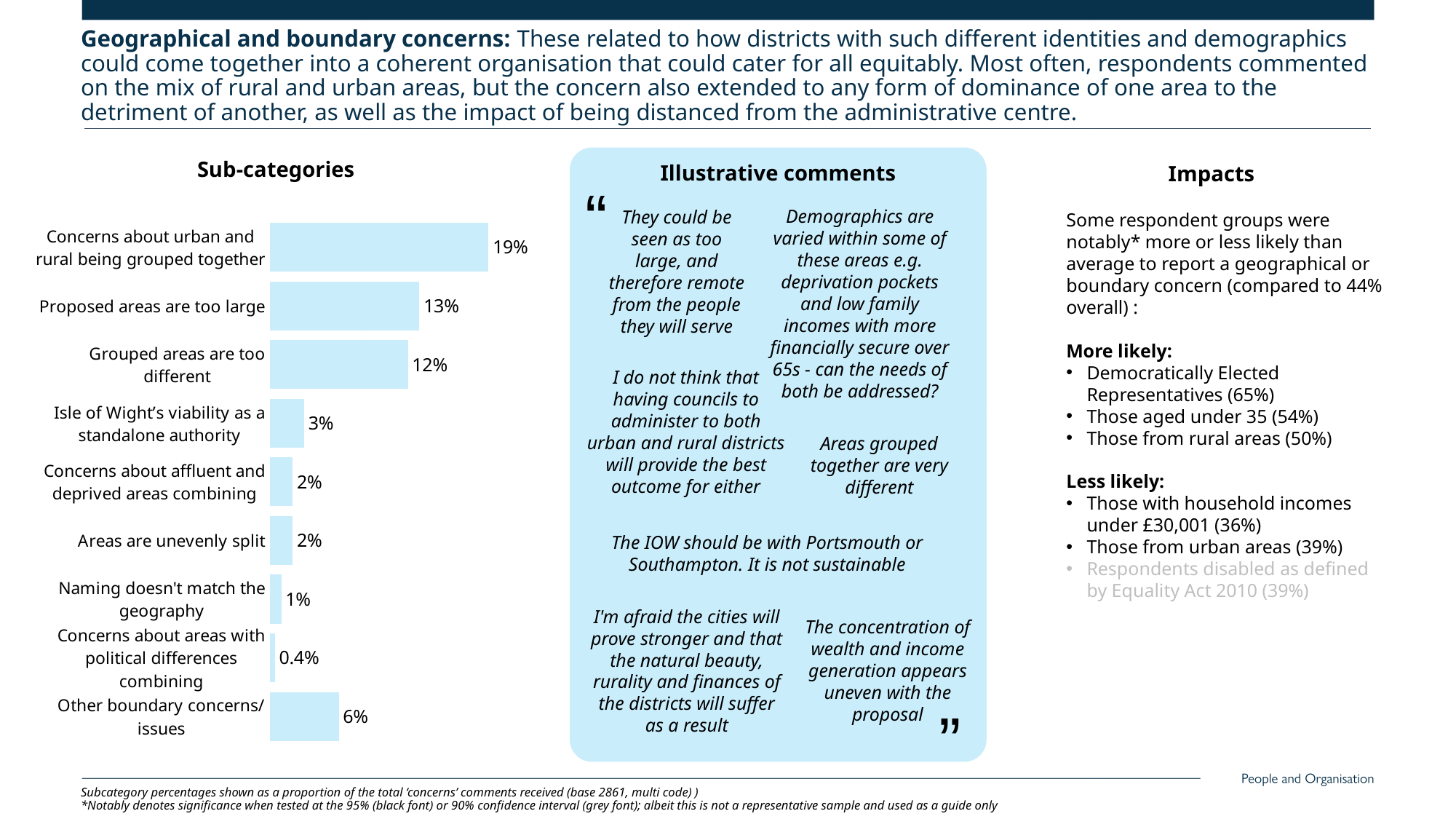
What is the title of the chart? Sub-categories What is the value for 'Proposed areas are too large'? 13% What type of chart is used to show the sub-categories? Bar chart What is the difference between 'Proposed areas are too large' and 'Grouped areas are too different'? 1% Which is larger: 'Other boundary concerns/ issues' or 'Isle of Wight's viability as a standalone authority'? Other boundary concerns/ issues What percentage is shown for 'Isle of Wight's viability as a standalone authority'? 3% Which sub-category has the highest percentage? Concerns about urban and rural being grouped together What is the difference between 'Concerns about urban and rural being grouped together' and 'Other boundary concerns/ issues'? 13% What percentage is shown for 'Concerns about urban and rural being grouped together'? 19% What is the value for 'Concerns about areas with political differences combining'? 0.4% Which sub-category has the lowest percentage? Concerns about areas with political differences combining How many sub-categories are shown in the chart? 9